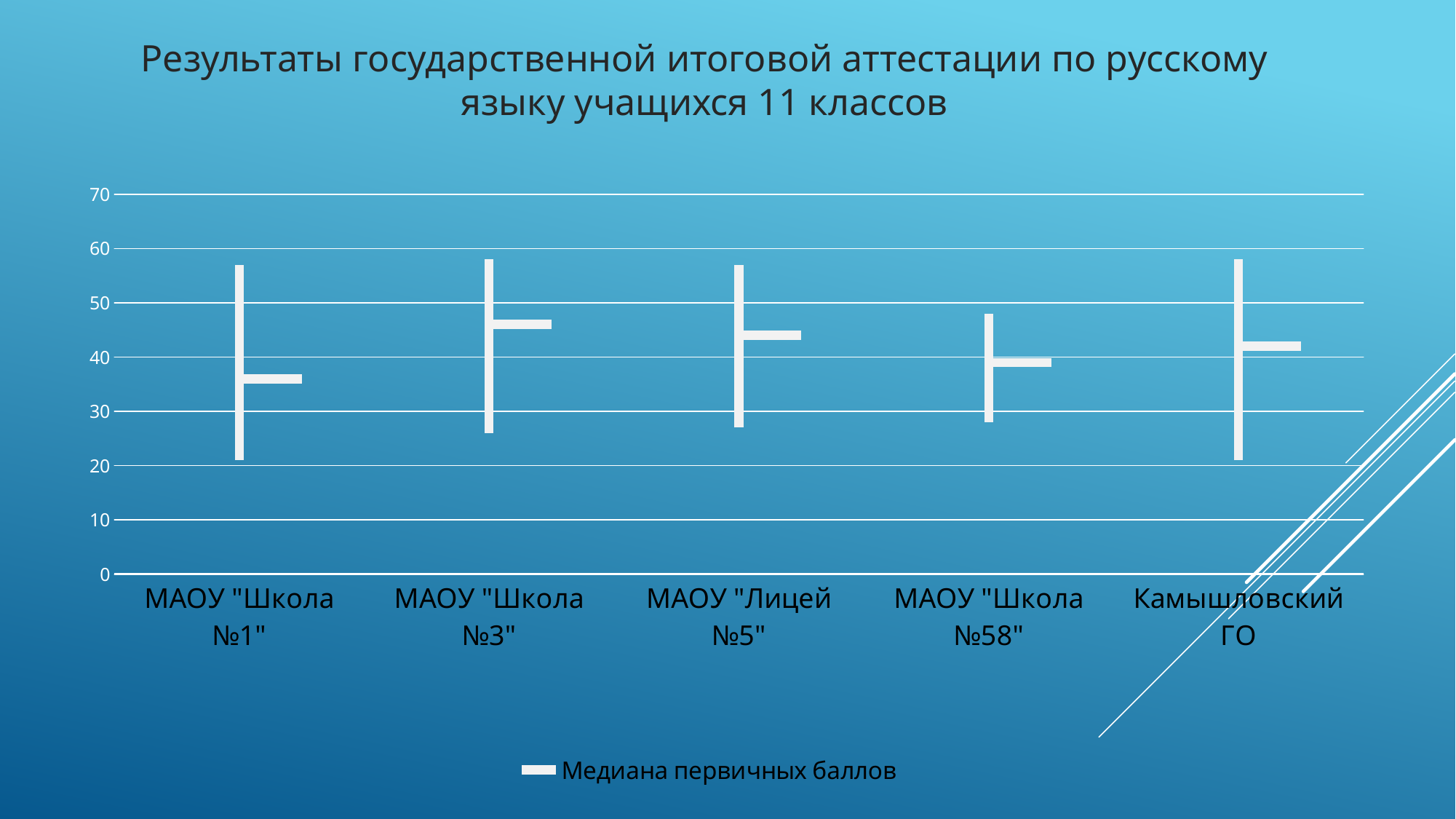
Is the median value for МАОУ "Лицей №5" greater or less than 40? greater What is the title of the chart? Результаты государственной итоговой аттестации по русскому языку учащихся 11 классов Is the median value for МАОУ "Школа №3" greater or less than 40? greater How many categories are shown on the x axis? 5 Which category has the lowest median value? МАОУ "Школа №1" Which has the larger median value, МАОУ "Школа №1" or МАОУ "Школа №3"? МАОУ "Школа №3" Is the upper end of the line for МАОУ "Школа №58" greater or less than 50? less How many series does the legend list? 1 Which has the larger median value, МАОУ "Школа №58" or МАОУ "Лицей №5"? МАОУ "Лицей №5" What is the legend entry of the chart? Медиана первичных баллов